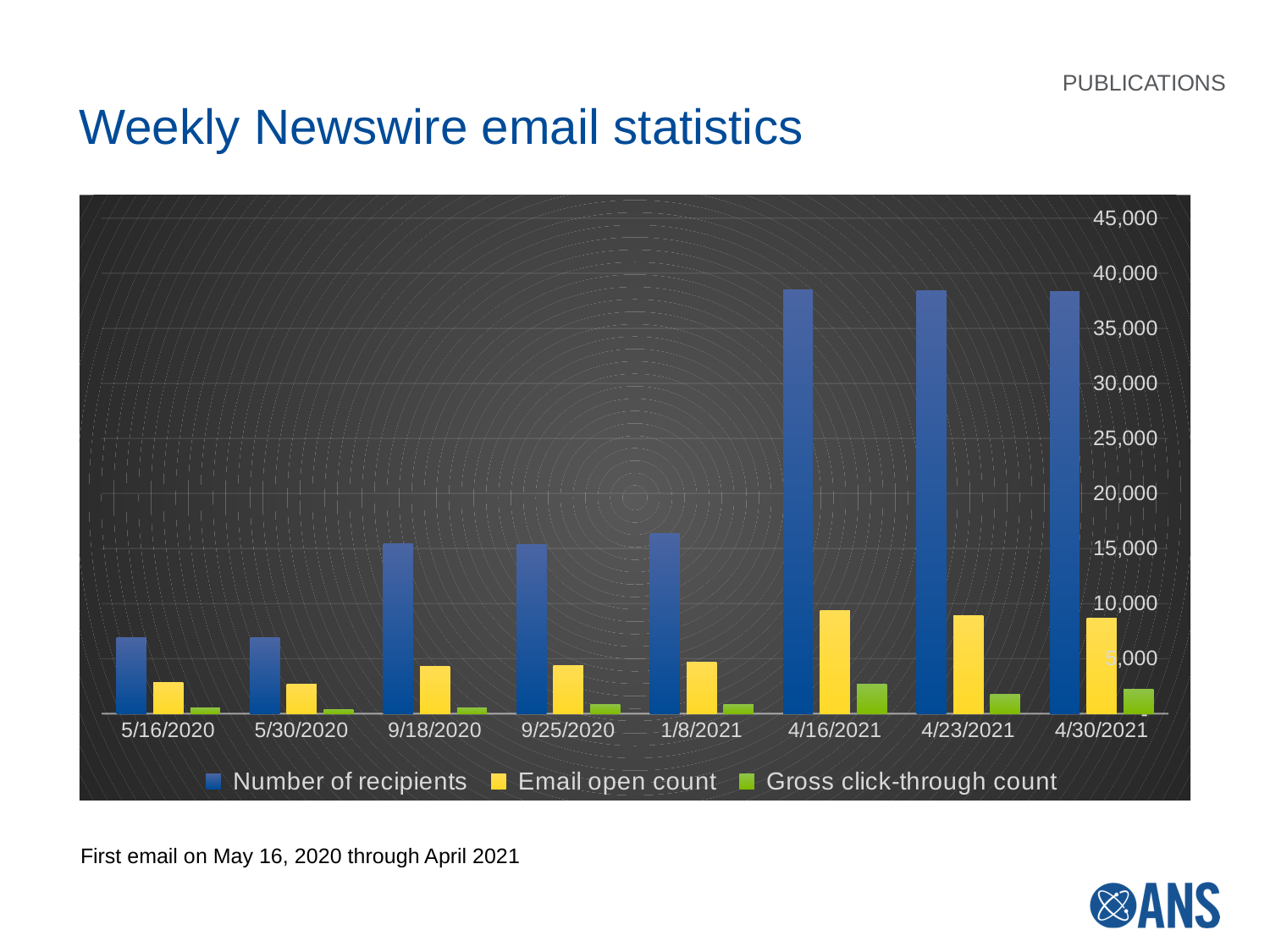
What kind of chart is shown on the slide? bar chart Does the Number of recipients generally rise or fall from 5/16/2020 to 4/30/2021? rise Is the Number of recipients for 4/16/2021 greater or less than 35,000? greater Is the Number of recipients for 5/16/2020 greater or less than 10,000? less Is the Number of recipients for 1/8/2021 greater or less than 15,000? greater How many series does the legend list? 3 How many dates are shown along the x axis? 8 What colour represents Email open count in the legend? yellow Which is larger, the Number of recipients on 1/8/2021 or on 5/30/2020? 1/8/2021 Which date has the highest Gross click-through count? 4/16/2021